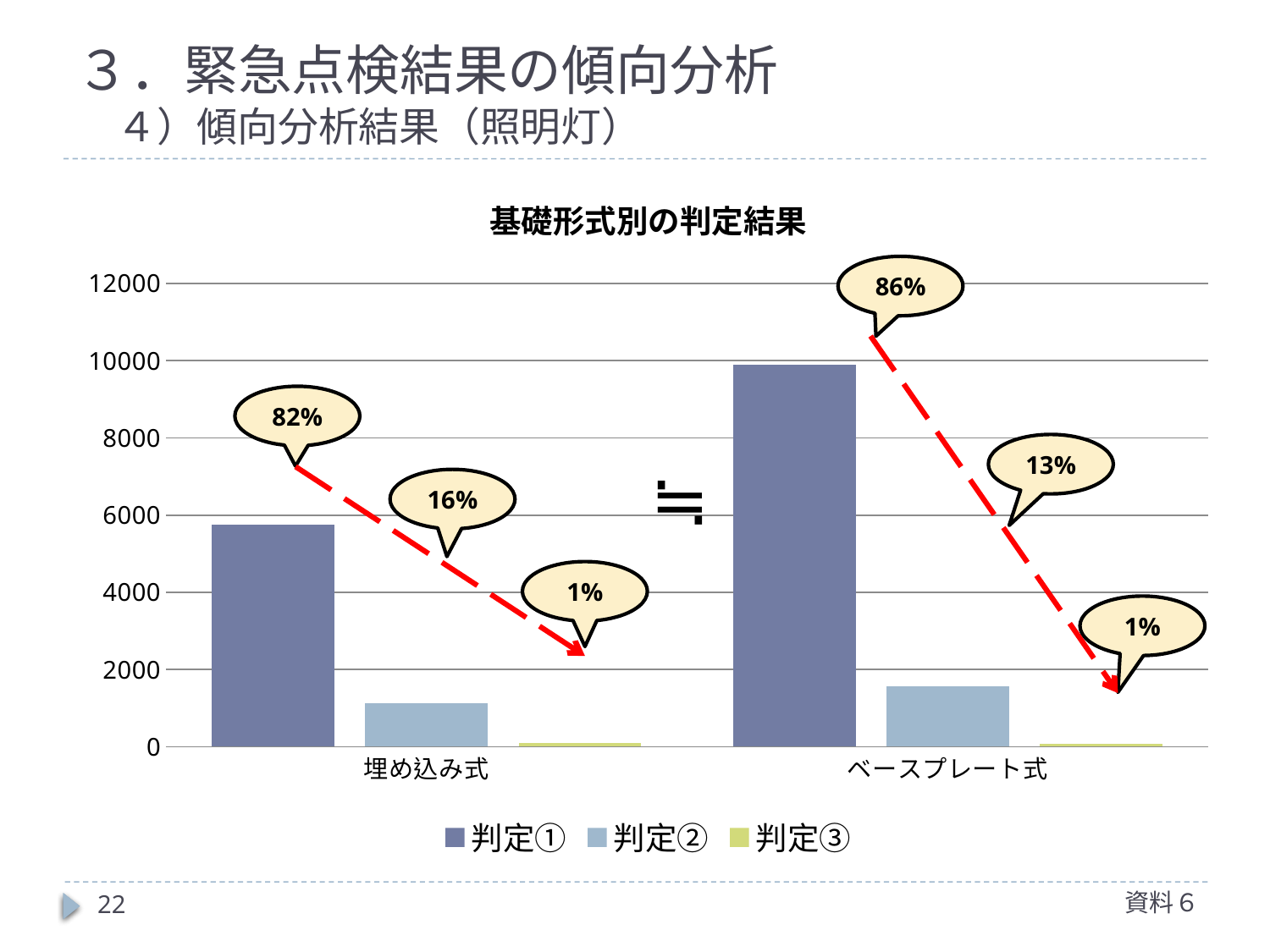
Which is larger, 判定① for 埋め込み式 or 判定① for ベースプレート式? 判定① for ベースプレート式 Which bar is the tallest in the chart? 判定① for ベースプレート式 What is the title of the chart? 基礎形式別の判定結果 What kind of chart is shown on the slide? bar chart How many series does the legend list? 3 How many categories are shown on the x axis? 2 What percentage is shown in the callout for 判定② of 埋め込み式? 16% Which is larger, 判定② for 埋め込み式 or 判定② for ベースプレート式? 判定② for ベースプレート式 Is the value of 判定② for ベースプレート式 greater or less than 2000? less What percentage is shown in the callout for 判定① of ベースプレート式? 86% Is the value of 判定① for ベースプレート式 greater or less than 8000? greater Is the value of 判定① for 埋め込み式 greater or less than 4000? greater